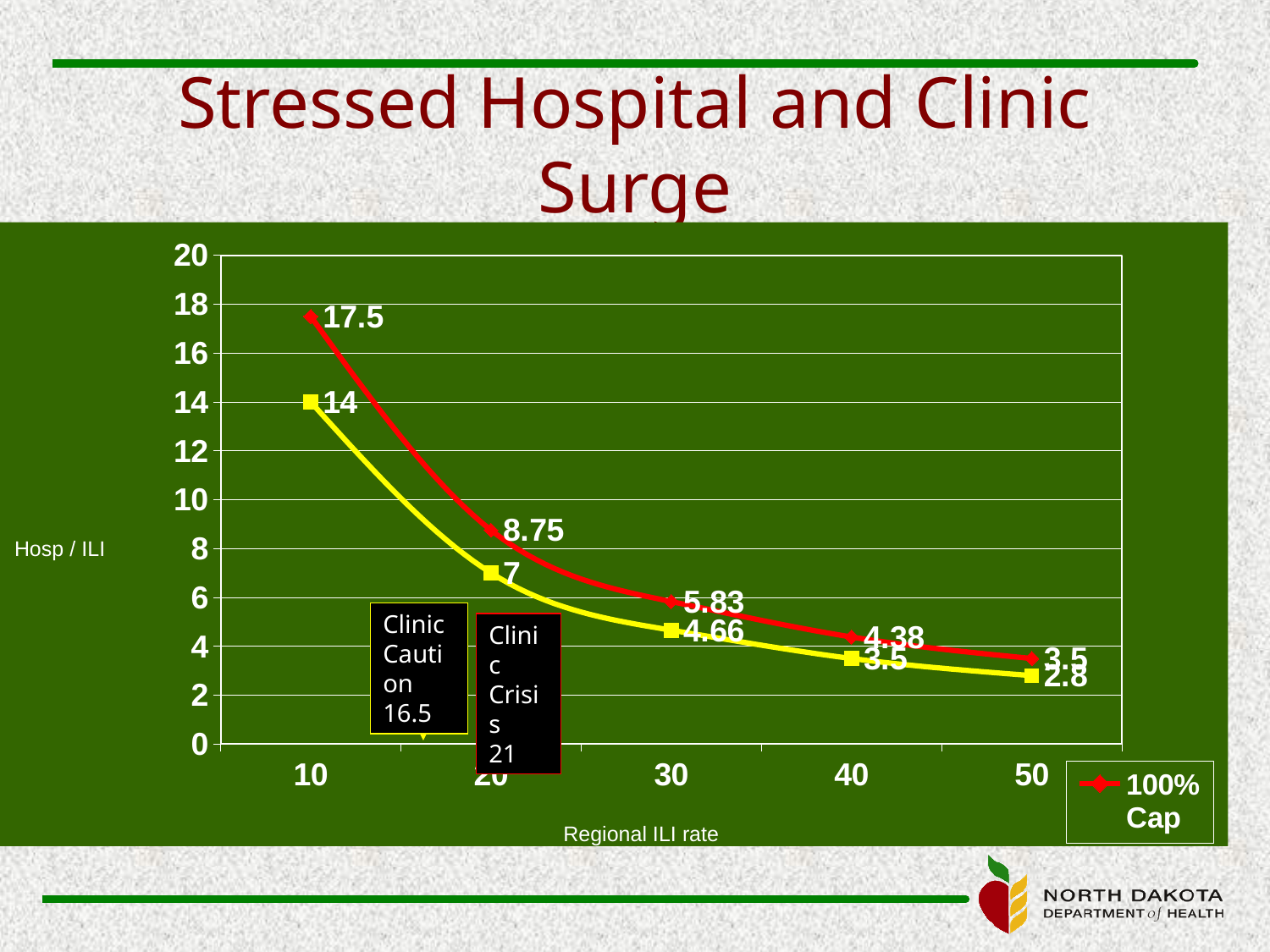
What is the value of the yellow line at a Regional ILI rate of 20? 7 What is the difference between the 100% Cap values at Regional ILI rates of 10 and 20? 8.75 At which Regional ILI rate is the 100% Cap series highest? 10 How many data points are plotted on the 100% Cap line? 5 What is the value of the 100% Cap series at a Regional ILI rate of 10? 17.5 What is the value of the 100% Cap series at a Regional ILI rate of 30? 5.83 What is the value of the yellow line at a Regional ILI rate of 50? 2.8 At which Regional ILI rate is the yellow line lowest? 50 At a Regional ILI rate of 40, which line has the larger value, the red 100% Cap line or the yellow line? the red 100% Cap line Do the values of the 100% Cap series rise or fall as the Regional ILI rate increases? fall What kind of chart is shown on the slide? line chart At a Regional ILI rate of 10, how much higher is the 100% Cap value than the yellow line's value? 3.5